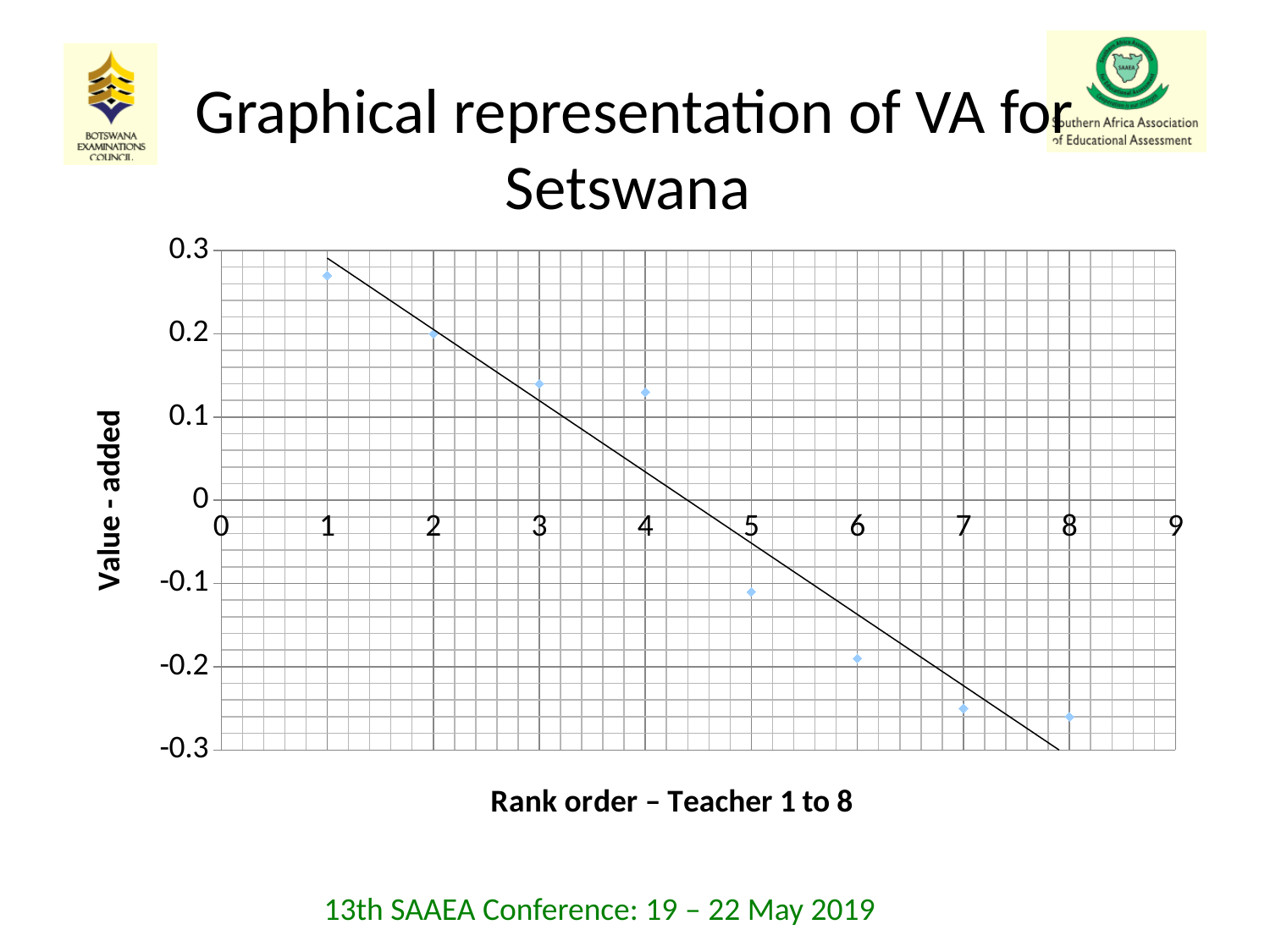
Is the value-added for teacher rank 1 greater or less than 0.2? greater Which has the larger value-added, teacher rank 5 or teacher rank 6? Teacher rank 5 Is the value-added for teacher rank 7 greater or less than -0.2? less What is the title of the vertical axis? Value - added Is the value-added for teacher rank 3 greater or less than 0.1? greater How many data points are plotted on the chart? 8 What is the title of the horizontal axis? Rank order – Teacher 1 to 8 Which teacher rank has the highest value-added? 1 What kind of chart is shown on the slide? Scatter chart Do the value-added points rise or fall as the rank order increases from teacher 1 to teacher 8? Fall